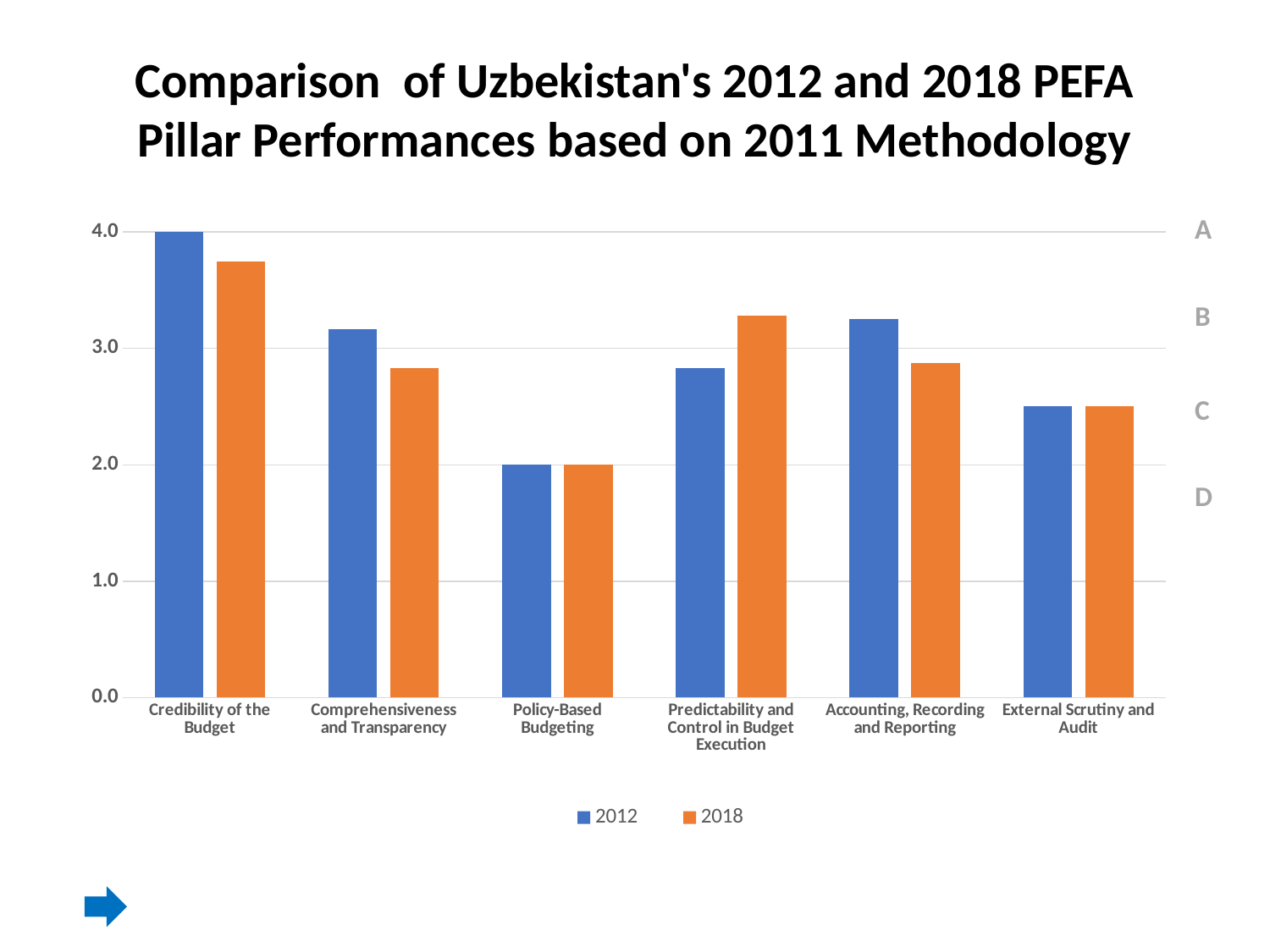
For Accounting, Recording and Reporting, which year has the larger value, 2012 or 2018? 2012 For Predictability and Control in Budget Execution, which year has the larger value, 2012 or 2018? 2018 Is the 2018 value for Comprehensiveness and Transparency greater or less than 3.0? less What is the difference between the 2012 values for Credibility of the Budget and Policy-Based Budgeting? 2.0 What type of chart is shown on the slide? bar chart What is the 2012 value for Credibility of the Budget? 4.0 How many series does the legend list? 2 Which pillar has the lowest 2018 value? Policy-Based Budgeting How many pillar categories are shown on the x axis? 6 Is the 2018 value for Credibility of the Budget greater or less than 3.0? greater Which pillar has the highest 2012 value? Credibility of the Budget What is the 2018 value for Policy-Based Budgeting? 2.0